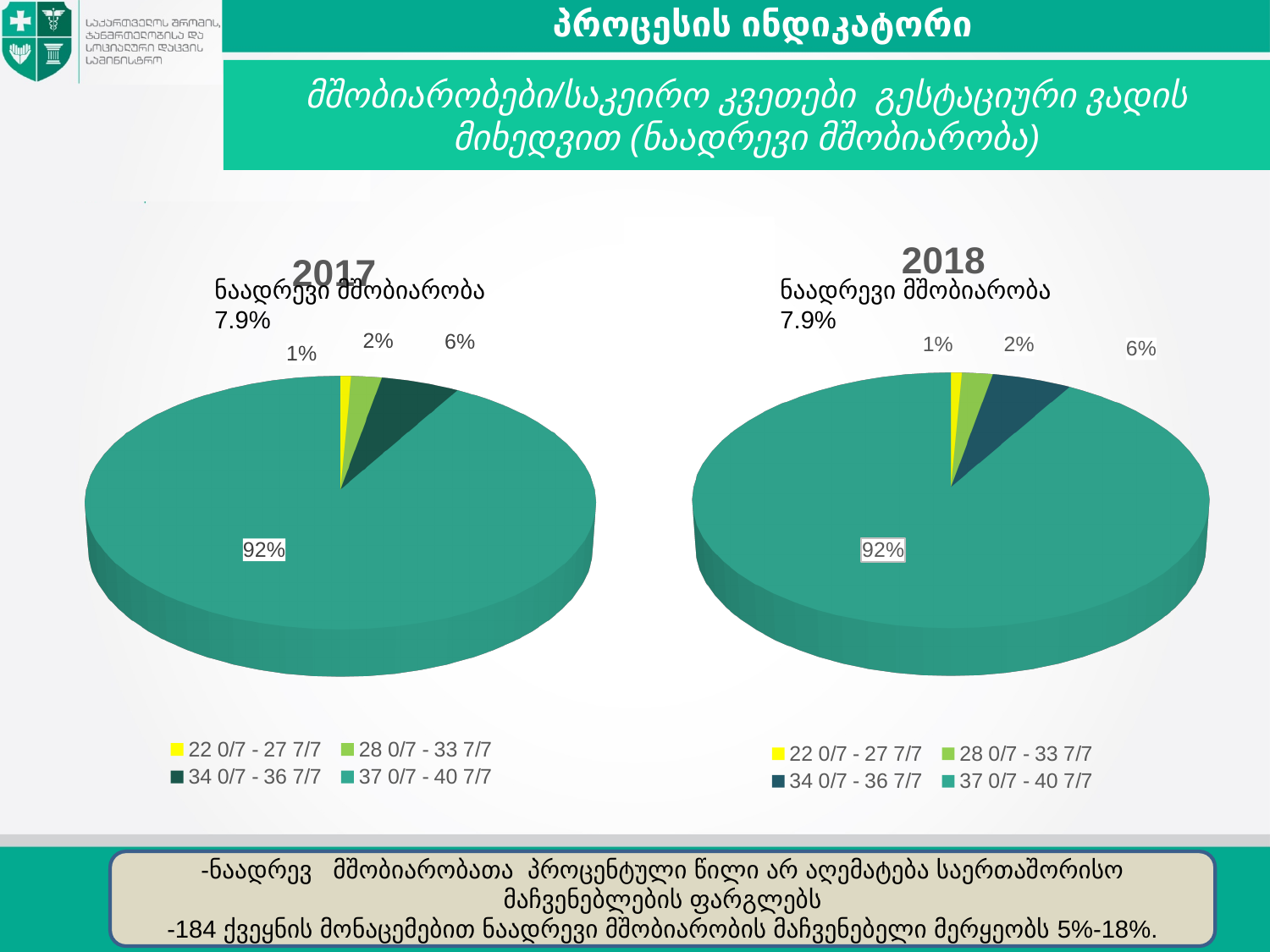
How many slices does the 2017 pie chart have? 4 In the 2017 chart, what percentage is shown for the 37 0/7 - 40 7/7 category? 92% In the 2018 chart, which category has the smallest slice? 22 0/7 - 27 7/7 What kind of chart is the 2017 chart on the left? Pie chart In the 2018 chart, what percentage is shown for the 22 0/7 - 27 7/7 category? 1% How many entries does the legend of the 2018 chart list? 4 In the 2017 chart's legend, what colour represents the 22 0/7 - 27 7/7 category? Yellow In the 2018 chart, what percentage is shown for the 34 0/7 - 36 7/7 category? 6% In the 2018 chart, which is larger: the 28 0/7 - 33 7/7 slice or the 34 0/7 - 36 7/7 slice? 34 0/7 - 36 7/7 In the 2017 chart, what is the difference in percentage points between the 37 0/7 - 40 7/7 slice and the 34 0/7 - 36 7/7 slice? 86 percentage points Is the share of the 37 0/7 - 40 7/7 category the same in the 2017 and 2018 charts? Yes, 92% in both In the 2017 chart, which category has the largest slice? 37 0/7 - 40 7/7